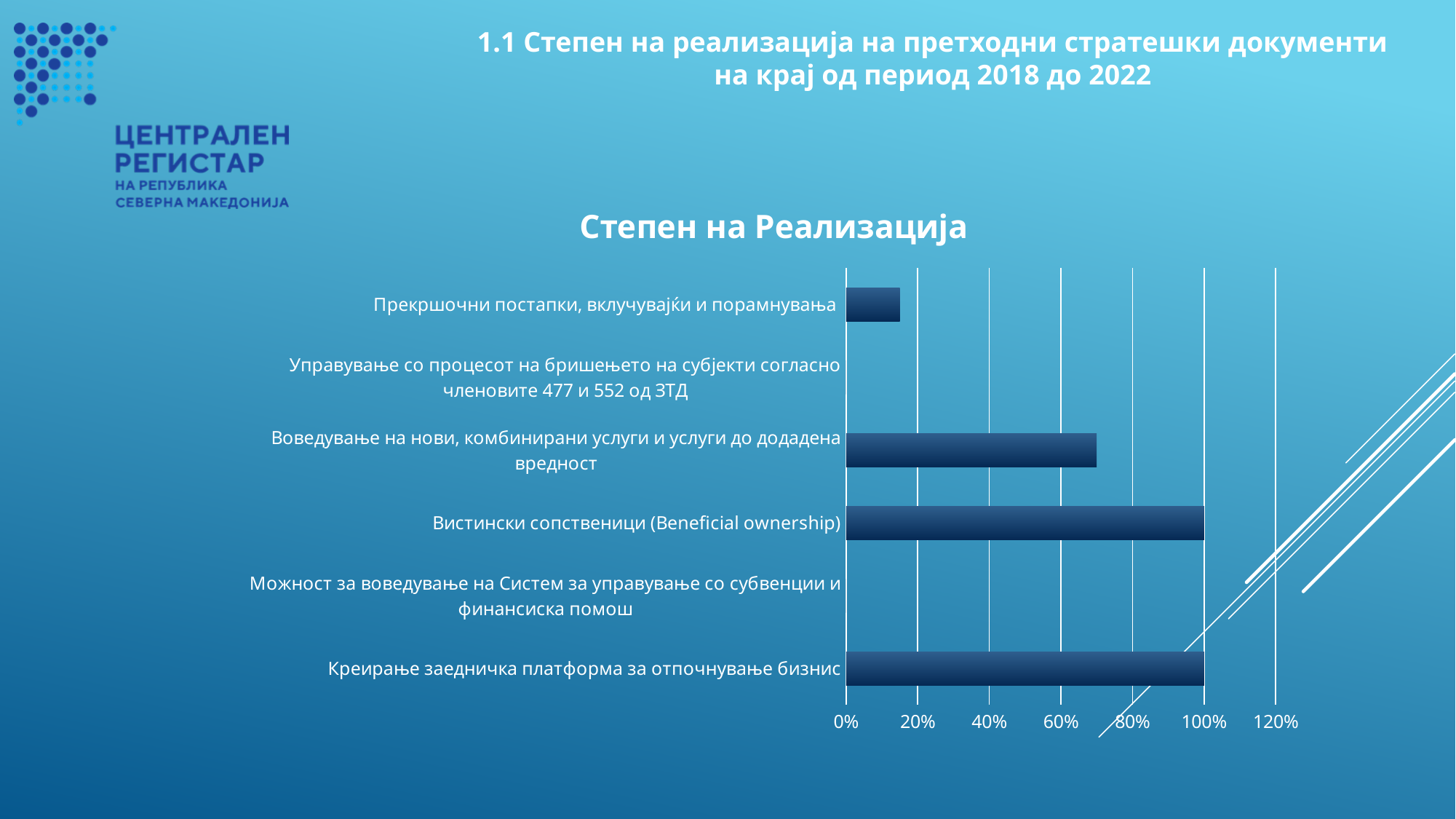
How many categories are shown in the chart? 6 What is the highest value shown on the x axis? 120% What is the value for Креирање заедничка платформа за отпочнување бизнис? 100% Which is larger: the value for Воведување на нови, комбинирани услуги и услуги до додадена вредност or the value for Прекршочни постапки, вклучувајќи и порамнувања? Воведување на нови, комбинирани услуги и услуги до додадена вредност What kind of chart is shown on the slide? bar chart What is the value for Вистински сопственици (Beneficial ownership)? 100% Is the value for Прекршочни постапки, вклучувајќи и порамнувања greater or less than 20%? less Is the value for Воведување на нови, комбинирани услуги и услуги до додадена вредност greater or less than 60%? greater Which is larger: the value for Вистински сопственици (Beneficial ownership) or the value for Воведување на нови, комбинирани услуги и услуги до додадена вредност? Вистински сопственици (Beneficial ownership) Is the value for Воведување на нови, комбинирани услуги и услуги до додадена вредност greater or less than 80%? less What is the title of the chart? Степен на Реализација